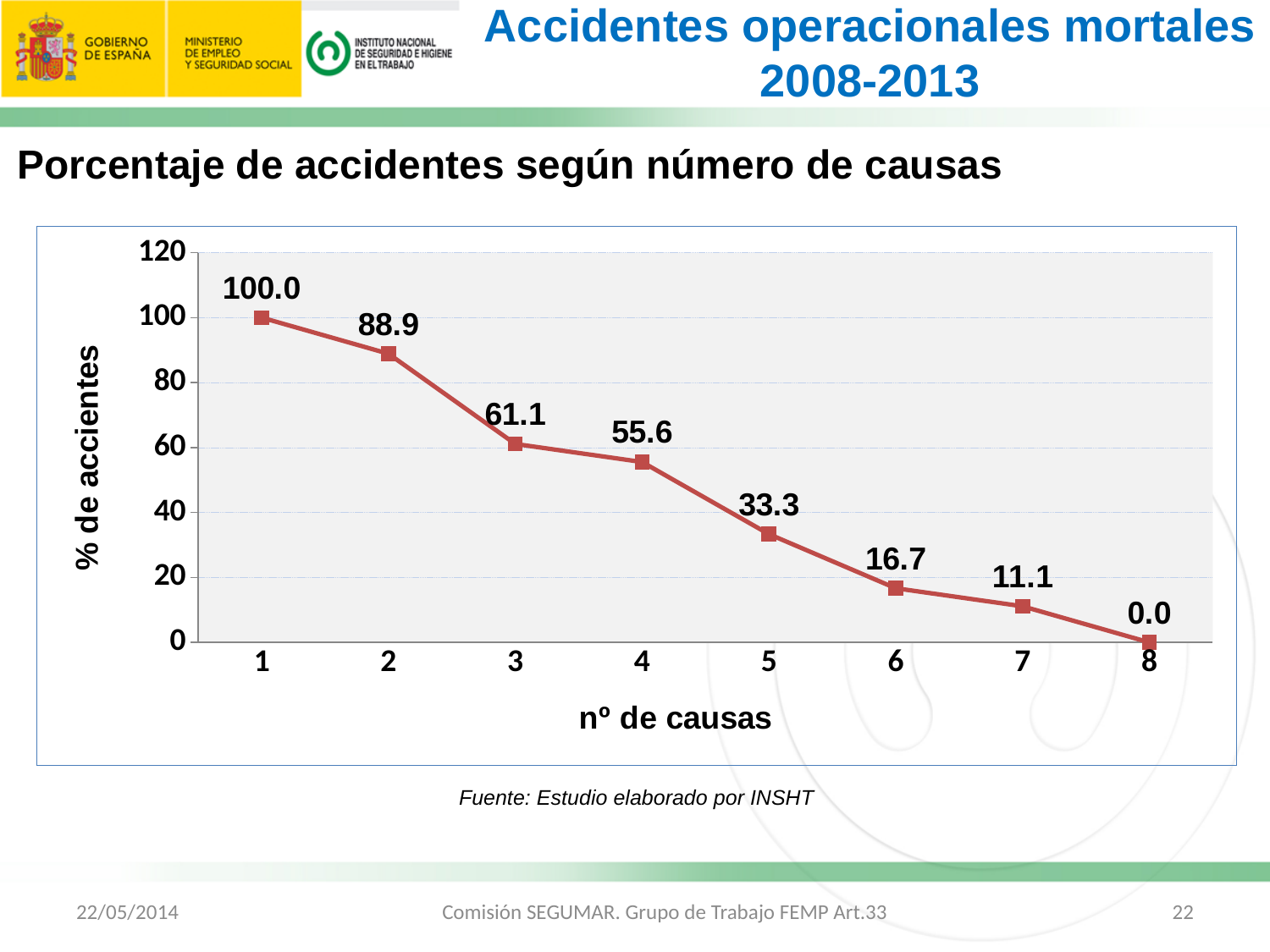
Do the values rise or fall as the number of causes increases? Fall What is the percentage of accidents for 7 causes? 11.1 Which is larger, the percentage for 4 causes or for 6 causes? 4 causes What is the percentage of accidents for 1 cause? 100.0 How many data points are plotted on the chart? 8 What is the difference between the percentage for 2 causes and for 4 causes? 33.3 What is the percentage of accidents for 3 causes? 61.1 What is the percentage of accidents for 5 causes? 33.3 Which number of causes has the lowest percentage of accidents? 8 Which number of causes has the highest percentage of accidents? 1 What is the label of the x axis? nº de causas What kind of chart is shown on the slide? Line chart